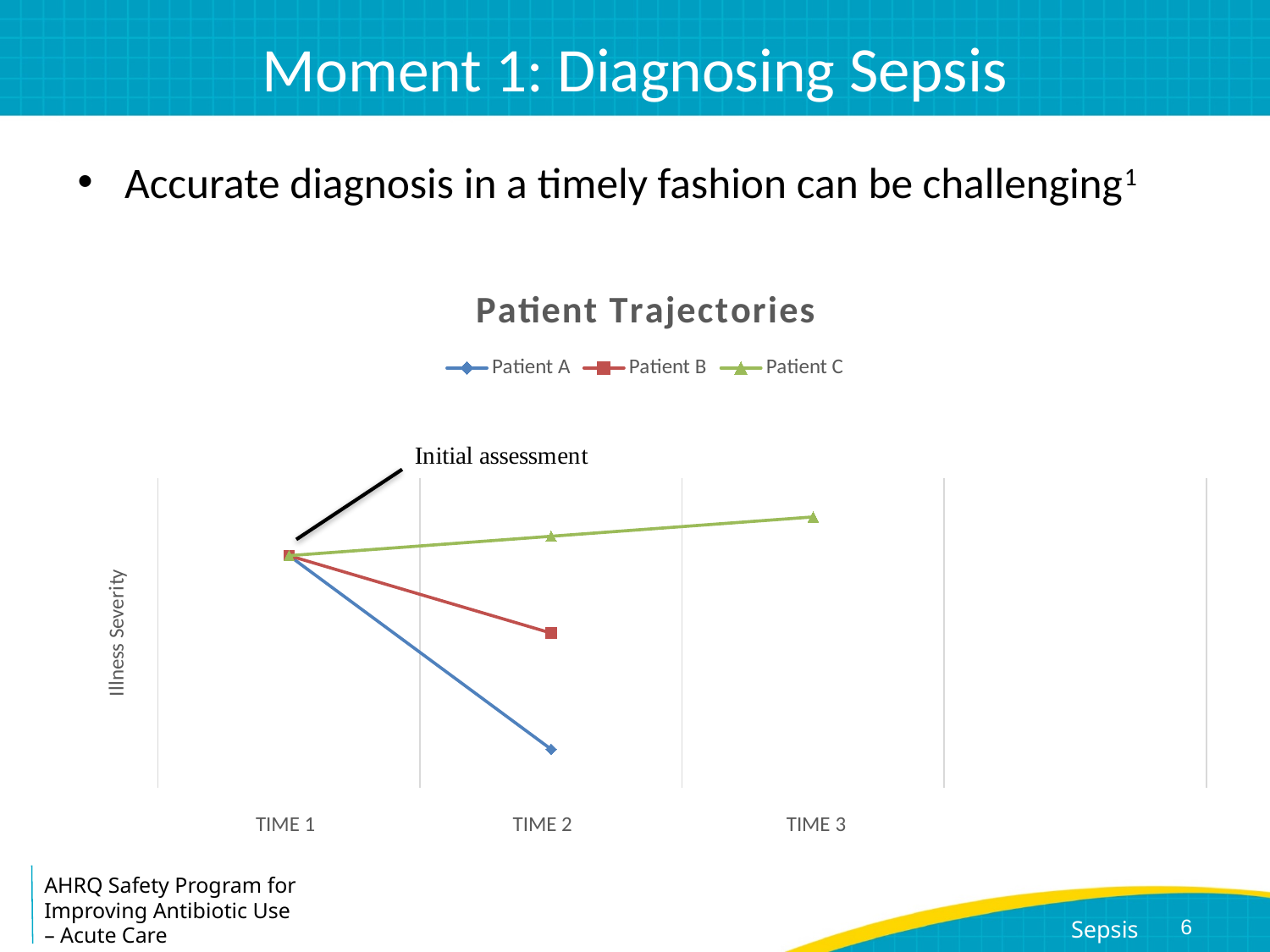
What is the label on the vertical axis of the chart? Illness Severity At TIME 2, is the illness severity for Patient B higher or lower than for Patient A? Higher Does the line for Patient C rise or fall from TIME 1 to TIME 3? Rise At TIME 2, which patient has the lowest illness severity? Patient A What kind of chart is shown on the slide? Line chart How many series does the chart's legend list? 3 Does the line for Patient B rise or fall from TIME 1 to TIME 2? Fall What is the title of the chart? Patient Trajectories Which patient's line extends to TIME 3? Patient C At TIME 2, which patient has the highest illness severity? Patient C Does the line for Patient A rise or fall from TIME 1 to TIME 2? Fall How many time points are labelled on the x axis of the chart? 3